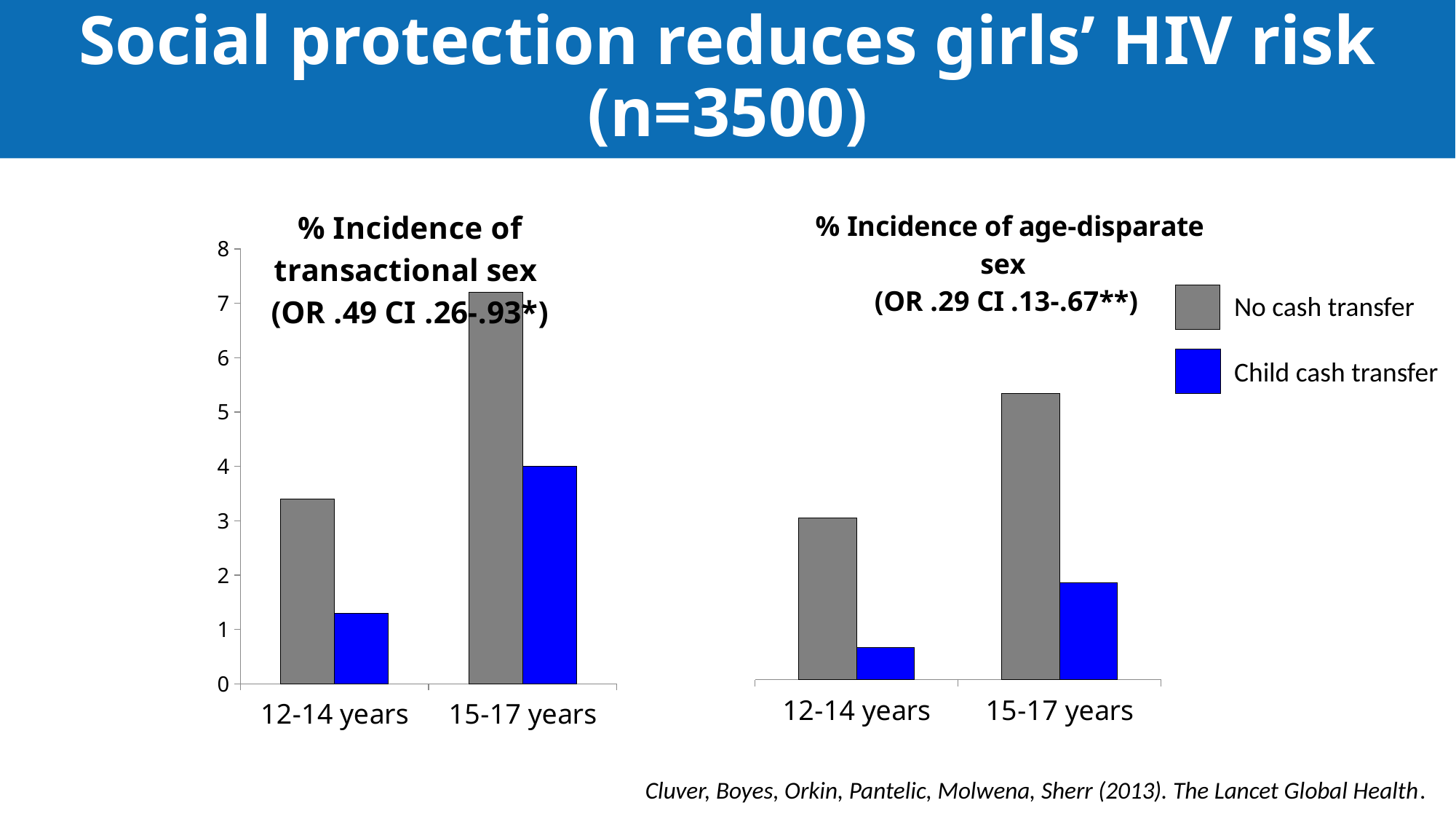
In the '% Incidence of age-disparate sex' chart, which age group and series has the shortest bar? 12-14 years, Child cash transfer In the '% Incidence of age-disparate sex' chart, for 15-17 years, which is larger: No cash transfer or Child cash transfer? No cash transfer How many series does the legend list for the charts on this slide? 2 In the '% Incidence of transactional sex' chart, is the No cash transfer value for 12-14 years greater or less than 3? greater What kind of chart is the '% Incidence of transactional sex' chart on the left? Bar chart In the '% Incidence of transactional sex' chart, is the Child cash transfer value for 12-14 years greater or less than 2? less In the '% Incidence of transactional sex' chart, for 12-14 years, which is larger: No cash transfer or Child cash transfer? No cash transfer What colour represents the Child cash transfer series in the legend? Blue In the '% Incidence of transactional sex' chart, is the No cash transfer value for 15-17 years greater or less than 7? greater In the '% Incidence of transactional sex' chart, which age group and series has the tallest bar? 15-17 years, No cash transfer In the '% Incidence of transactional sex' chart, how many age-group categories are shown on the x axis? 2 In the '% Incidence of transactional sex' chart, does the No cash transfer value rise or fall from 12-14 years to 15-17 years? rise